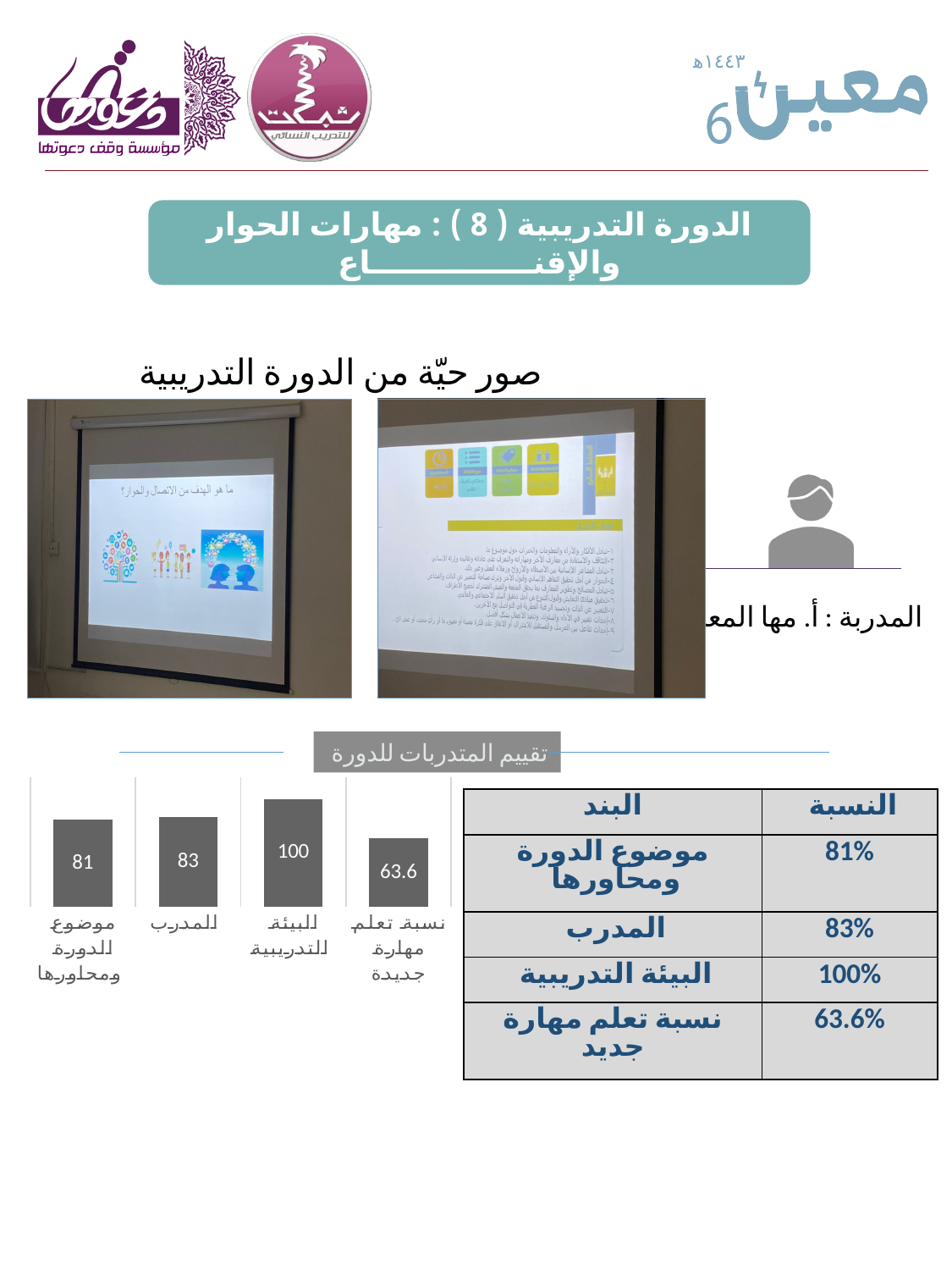
In the bar chart, what is the value for "موضوع الدورة ومحاورها"? 81 In the bar chart, what is the value for "نسبة تعلم مهارة جديدة"? 63.6 In the bar chart, which is larger: the value for "المدرب" or the value for "نسبة تعلم مهارة جديدة"? المدرب In the bar chart, what is the difference between the values for "البيئة التدريبية" and "نسبة تعلم مهارة جديدة"? 36.4 Which category has the highest value in the bar chart? البيئة التدريبية What type of chart is shown at the bottom of the slide under "تقييم المتدربات للدورة"? bar chart In the bar chart, what is the value for "البيئة التدريبية"? 100 How many bars does the chart under "تقييم المتدربات للدورة" have? 4 In the bar chart, what is the value for "المدرب"? 83 Which category has the lowest value in the bar chart? نسبة تعلم مهارة جديدة In the bar chart, what is the difference between the values for "المدرب" and "موضوع الدورة ومحاورها"? 2 What colour are the bars in the bar chart? grey